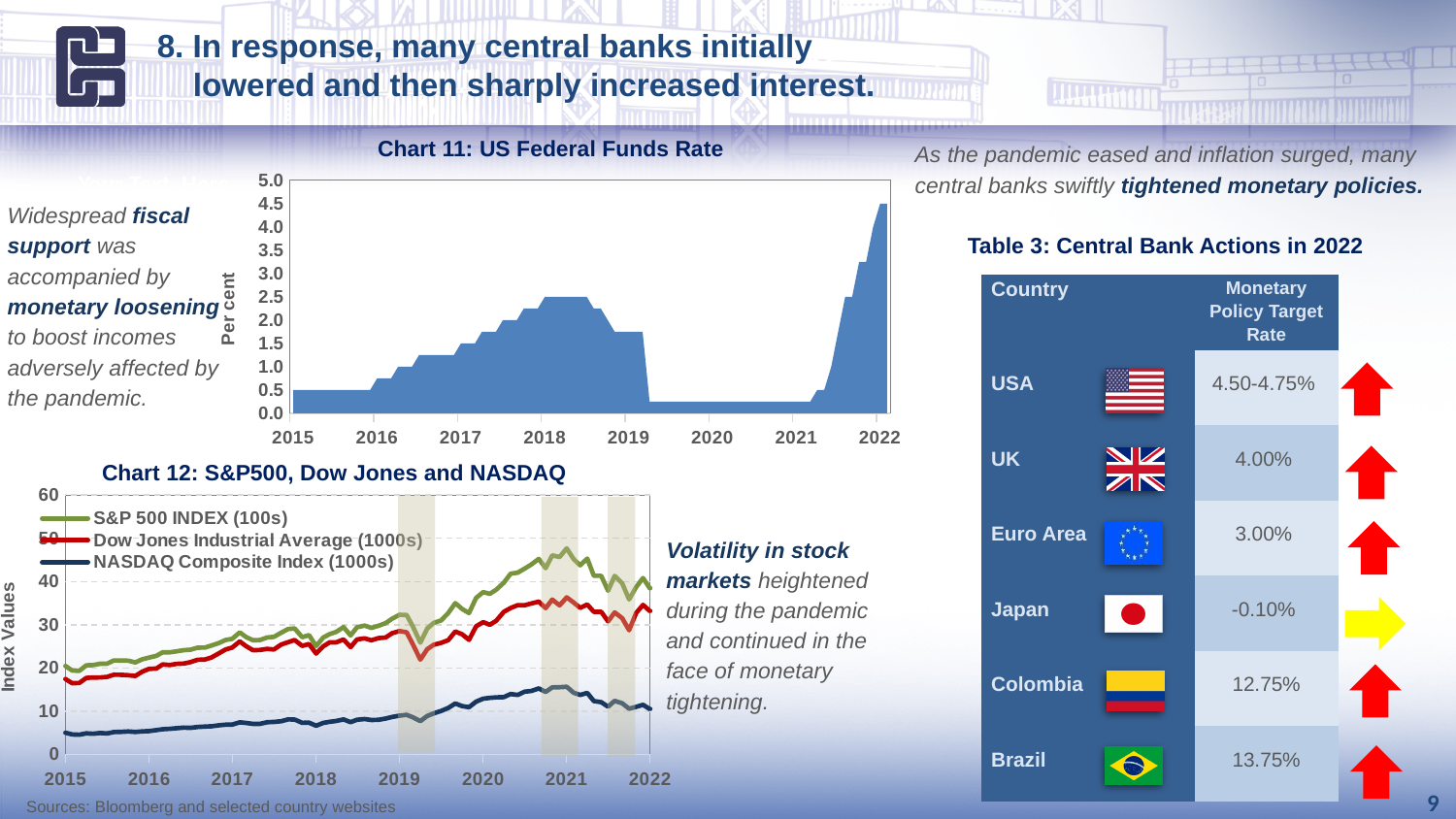
In Chart 12, does the NASDAQ Composite Index rise or fall between 2015 and 2021? rise In Chart 11, does the US Federal Funds Rate rise or fall between 2016 and 2018? rise In Chart 12, is the NASDAQ Composite Index value in 2015 greater or less than 10? less In Chart 12, which series reaches the highest index value in 2021? S&P 500 INDEX (100s) In Chart 11, is the US Federal Funds Rate at the start of 2015 greater or less than 1.0 per cent? less What kind of chart is Chart 11: US Federal Funds Rate? Area chart In Chart 11, is the US Federal Funds Rate during 2020 greater or less than 0.5 per cent? less What is the y-axis label of Chart 11? Per cent In Chart 12, which series has the lowest index values across the whole period? NASDAQ Composite Index (1000s) What kind of chart is Chart 12: S&P500, Dow Jones and NASDAQ? Line chart How many series does the legend of Chart 12 list? 3